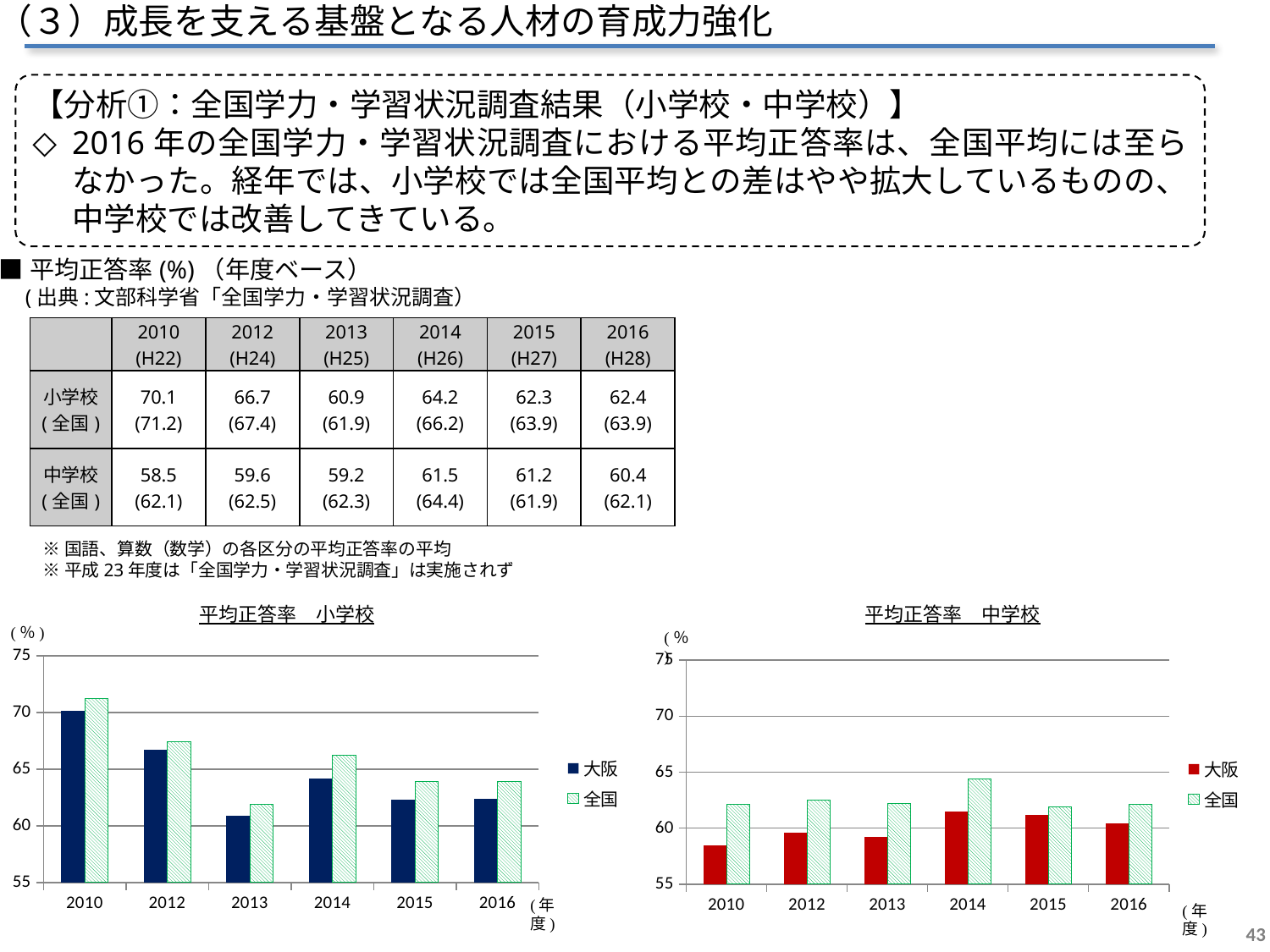
In the 平均正答率 中学校 chart, which is larger in 2014, 大阪 or 全国? 全国 How many series does the legend of the 平均正答率 中学校 chart list? 2 According to the table, what is the 小学校 average correct-answer rate for 大阪 in 2016 (H28)? 62.4 What kind of chart is the 平均正答率 小学校 chart on the left? bar chart In the 平均正答率 中学校 chart, is the 大阪 value for 2010 greater or less than 60? less In the 平均正答率 小学校 chart, does the 全国 series overall rise or fall from 2010 to 2016? fall According to the table, what is the difference between the 全国 and 大阪 中学校 values in 2016 (H28)? 1.7 In the 平均正答率 中学校 chart, in which year is the 全国 bar highest? 2014 In the 平均正答率 小学校 chart, in which year is the 大阪 bar lowest? 2013 In the 平均正答率 小学校 chart, in which year is the 大阪 bar highest? 2010 In the 平均正答率 小学校 chart, is the 全国 value for 2010 greater or less than 70? greater How many years are shown on the x axis of the 平均正答率 小学校 chart? 6